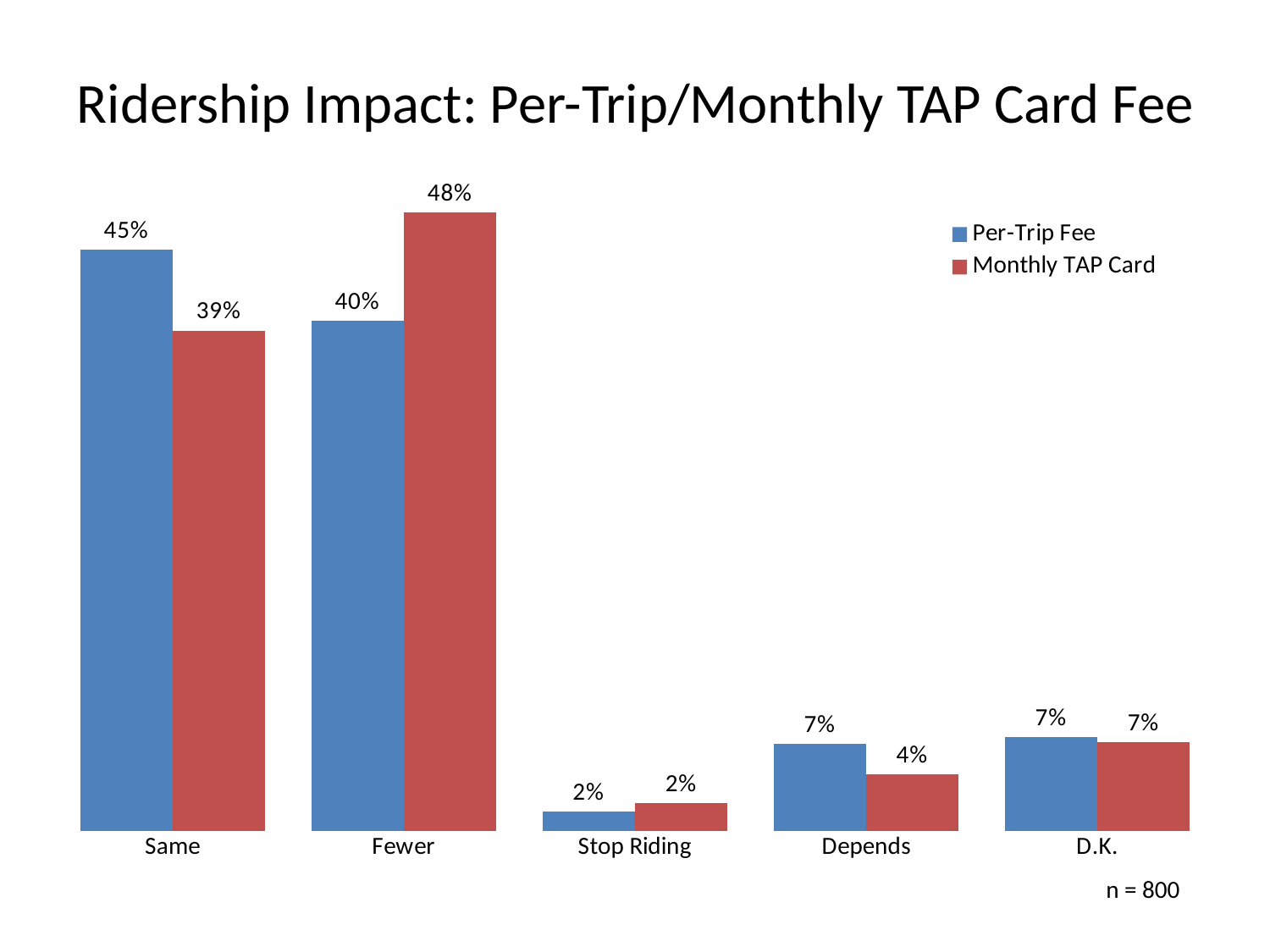
What is the sample size noted on the slide? n = 800 How many series does the legend list? 2 For Depends, which is larger: the Per-Trip Fee value or the Monthly TAP Card value? Per-Trip Fee What is the Monthly TAP Card value for Depends? 4% Which category has the highest Monthly TAP Card value? Fewer How many categories are shown on the x axis? 5 Which category has the lowest Per-Trip Fee value? Stop Riding What is the Per-Trip Fee value for Same? 45% What kind of chart is shown on the slide? Bar chart What is the Monthly TAP Card value for Fewer? 48% What is the difference between the Per-Trip Fee and Monthly TAP Card values for Same? 6% What is the difference between the Monthly TAP Card and Per-Trip Fee values for Fewer? 8%